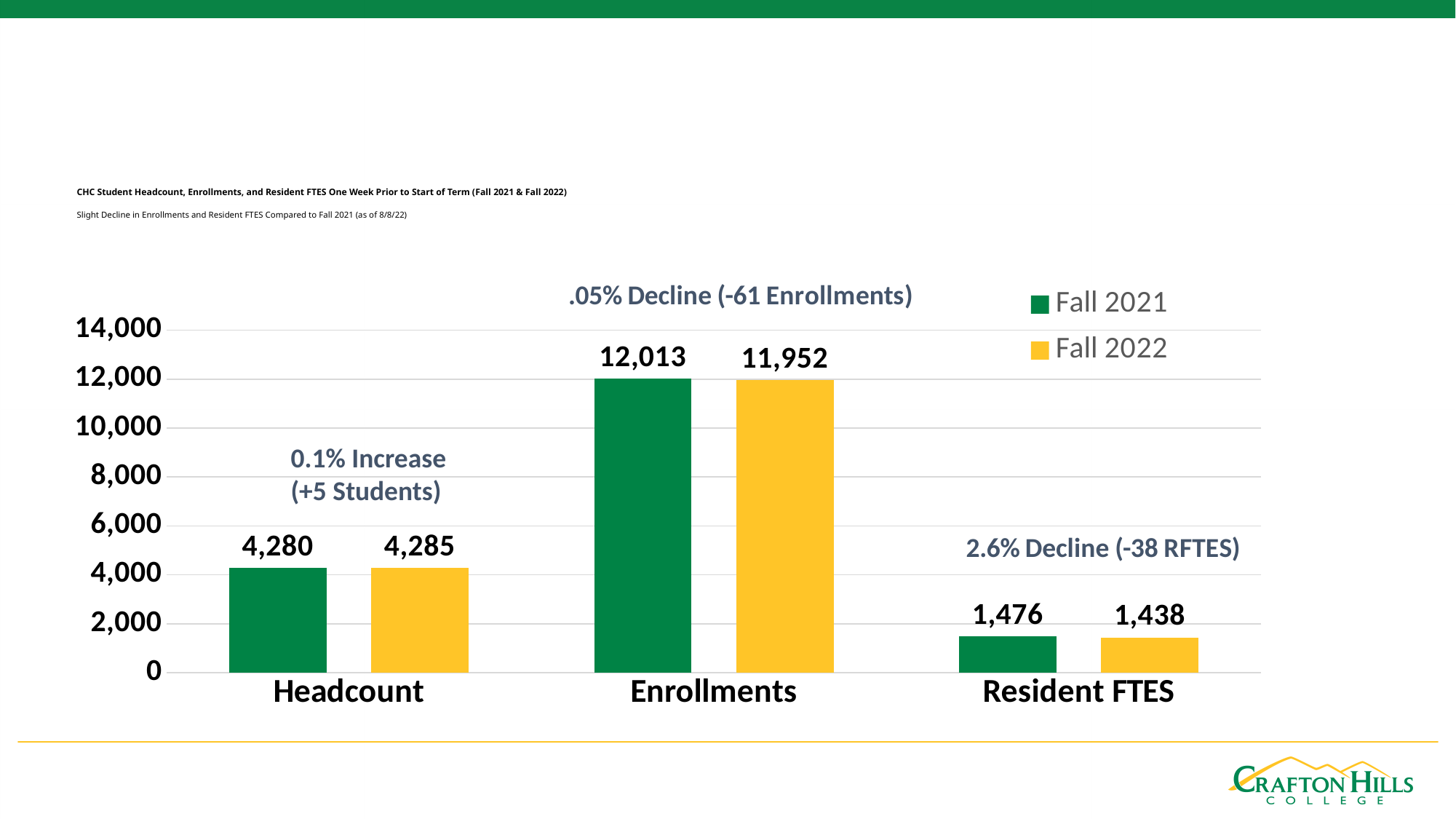
What is the Fall 2022 value for Enrollments? 11,952 What is the Fall 2021 value for Resident FTES? 1,476 What is the Fall 2022 value for Resident FTES? 1,438 How many series does the legend list? 2 What kind of chart is shown on the slide? bar chart Which category has the lowest Fall 2022 value? Resident FTES How many categories are shown on the x axis? 3 Is the Fall 2022 value for Headcount greater or less than 6,000? less What is the Fall 2021 value for Headcount? 4,280 Which is larger for Resident FTES, the Fall 2021 value or the Fall 2022 value? Fall 2021 Which category has the highest Fall 2021 value? Enrollments What is the difference between the Fall 2021 and Fall 2022 values for Enrollments? 61